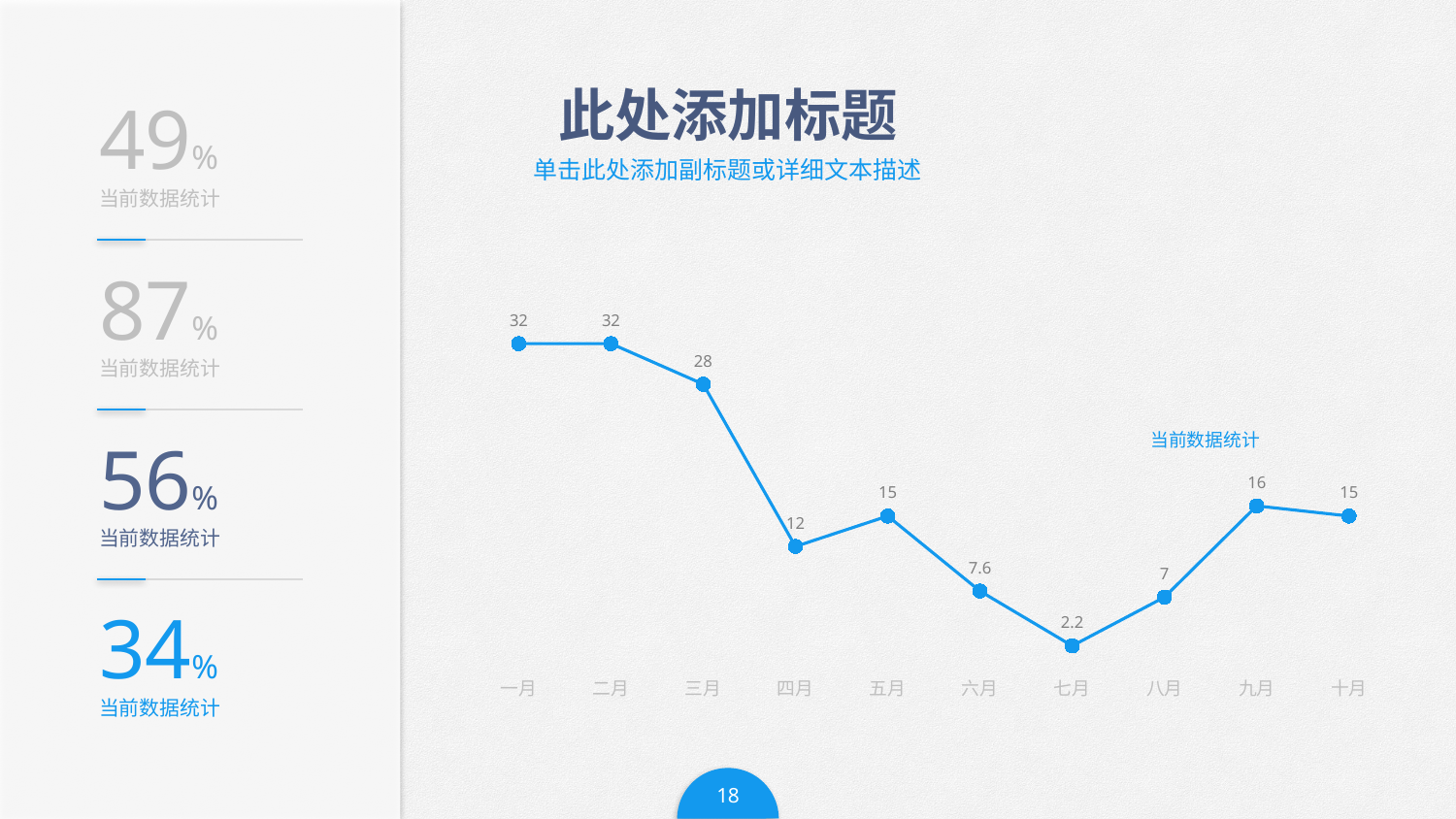
What is the value for 九月 (September)? 16 What is the difference between the values for 三月 and 四月? 16 Which is larger, the value for 五月 or the value for 六月? 五月 How many months are plotted on the x axis? 10 What is the difference between the values for 八月 and 七月? 4.8 What is the highest value plotted on the chart? 32 What is the value for 六月 (June)? 7.6 What is the value for 三月 (March)? 28 Which month has the lowest value? 七月 Does the line rise or fall from 一月 to 四月? fall What type of chart is shown on the slide? line chart